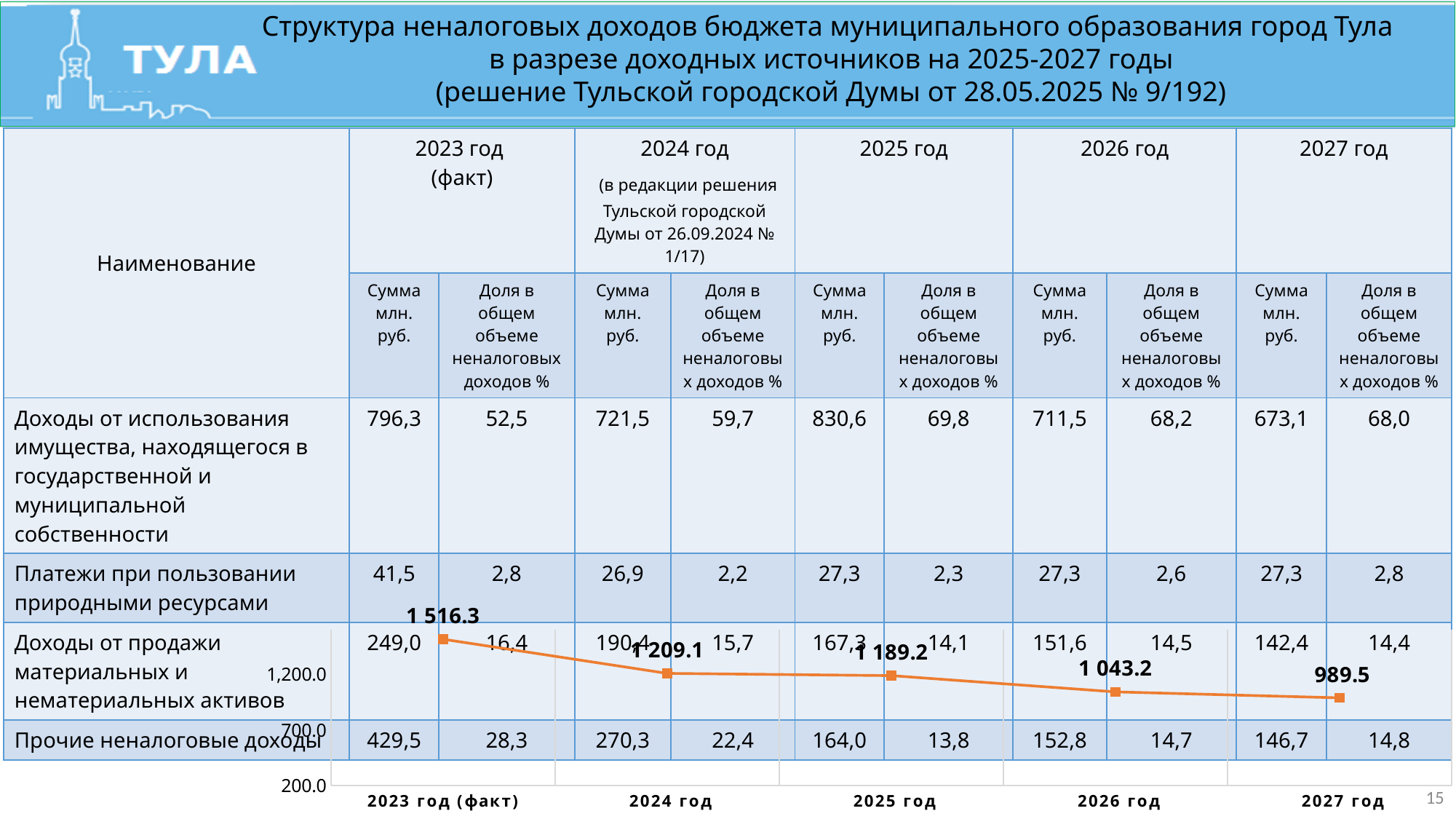
In the line chart, how many data points are plotted? 5 In the line chart, what is the value for 2023 год (факт)? 1 516.3 In the line chart, which is larger: the value for 2024 год or the value for 2026 год? 2024 год In the line chart, what is the value for 2026 год? 1 043.2 In the line chart, which year has the highest value? 2023 год (факт) In the line chart, what is the value for 2027 год? 989.5 In the line chart, what is the difference between the values for 2023 год (факт) and 2027 год? 526.8 In the line chart, what is the value for 2025 год? 1 189.2 What type of chart is overlaid on the lower part of the slide? line chart In the line chart, what is the value for 2024 год? 1 209.1 In the line chart, do the values rise or fall from 2023 to 2027? fall In the line chart, which year has the lowest value? 2027 год